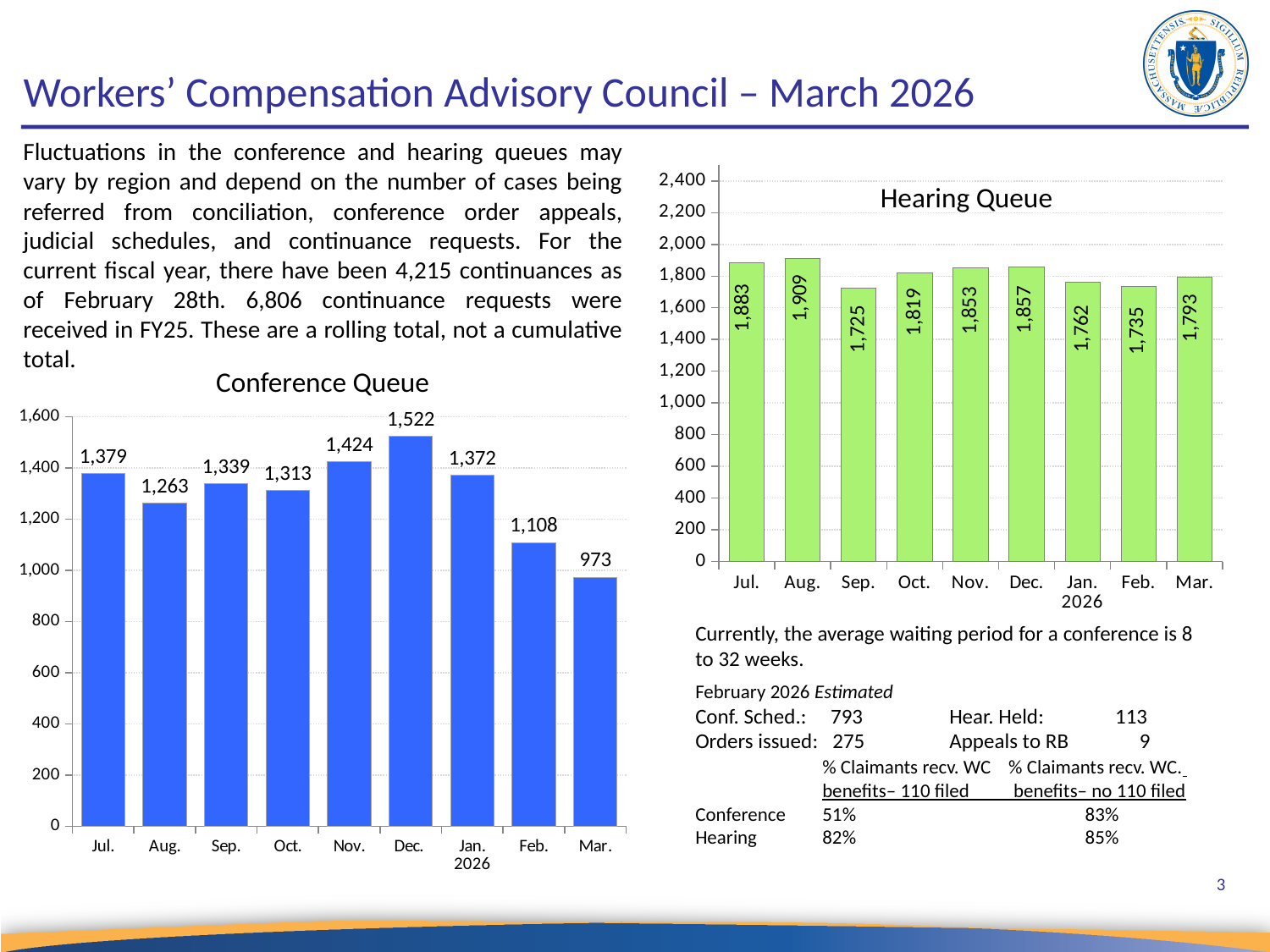
In the Hearing Queue chart, is the value for Feb. greater or less than 1,800? less In the Hearing Queue chart, which month has the highest value? Aug. How many months are shown in the Conference Queue chart? 9 In the Conference Queue chart, what is the value for Dec.? 1,522 In the Conference Queue chart, what is the difference between the Dec. and Mar. values? 549 In the Conference Queue chart, which month has the lowest value? Mar. What kind of chart is the Hearing Queue chart? bar chart In the Hearing Queue chart, what is the difference between the Aug. and Sep. values? 184 What colour are the bars in the Hearing Queue chart? green In the Conference Queue chart, do the values rise or fall from Dec. to Mar.? fall In the Hearing Queue chart, what is the value for Sep.? 1,725 In the Conference Queue chart, which is larger, the value for Jul. or the value for Aug.? Jul.